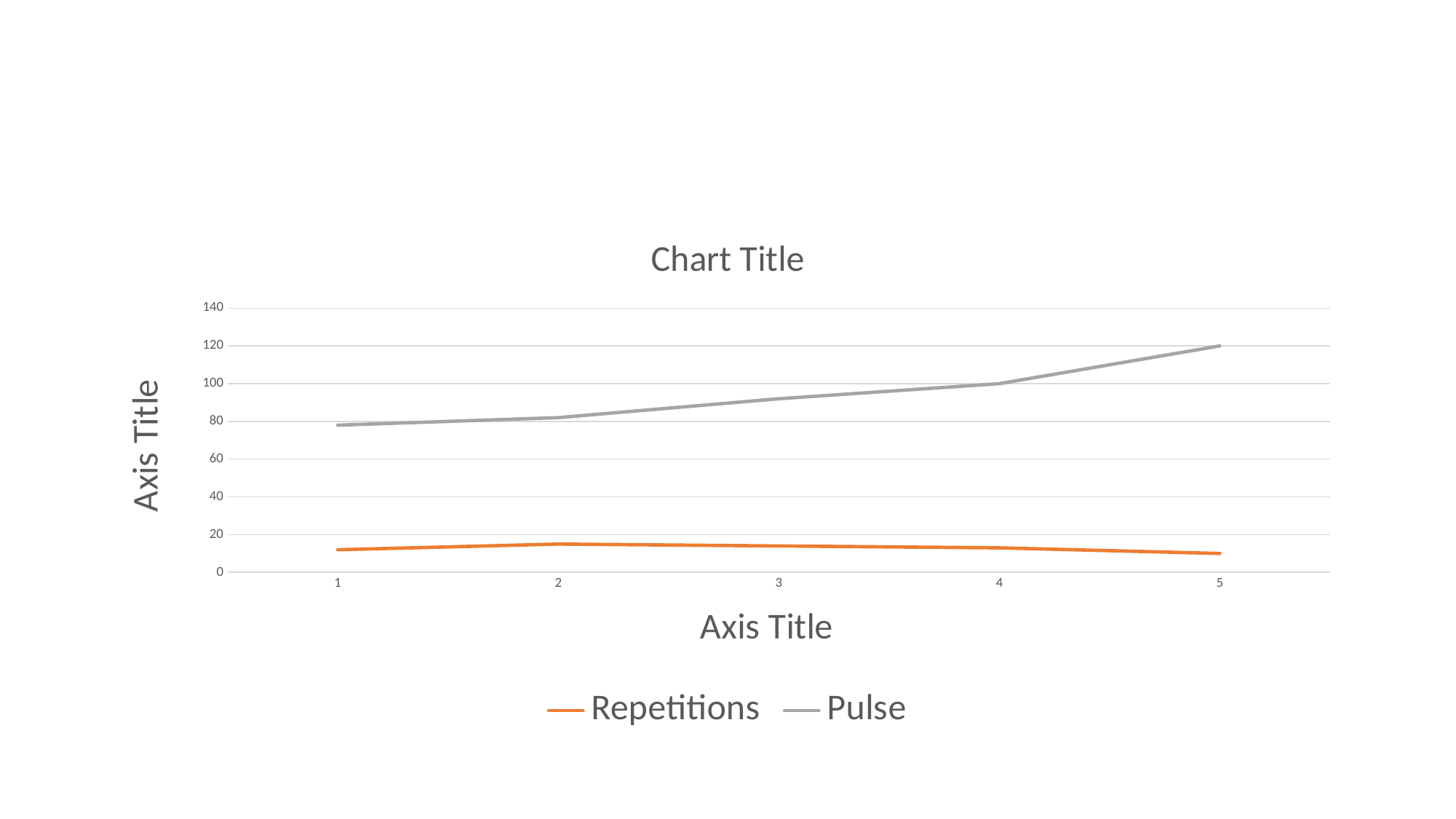
Is the value for Repetitions at x = 2 greater or less than 20? less Which series has the larger value at x = 3, Repetitions or Pulse? Pulse At which x value is Pulse highest? 5 How many series does the legend list? 2 What is the value of Pulse at x = 5? 120 Is the value for Pulse at x = 3 greater or less than 100? less What is the value of Pulse at x = 4? 100 What colour is the Pulse line? gray Does the Pulse series rise or fall from x = 1 to x = 5? rise What kind of chart is shown on the slide? line chart At which x value is Pulse lowest? 1 How many points are plotted along the x axis for each series? 5